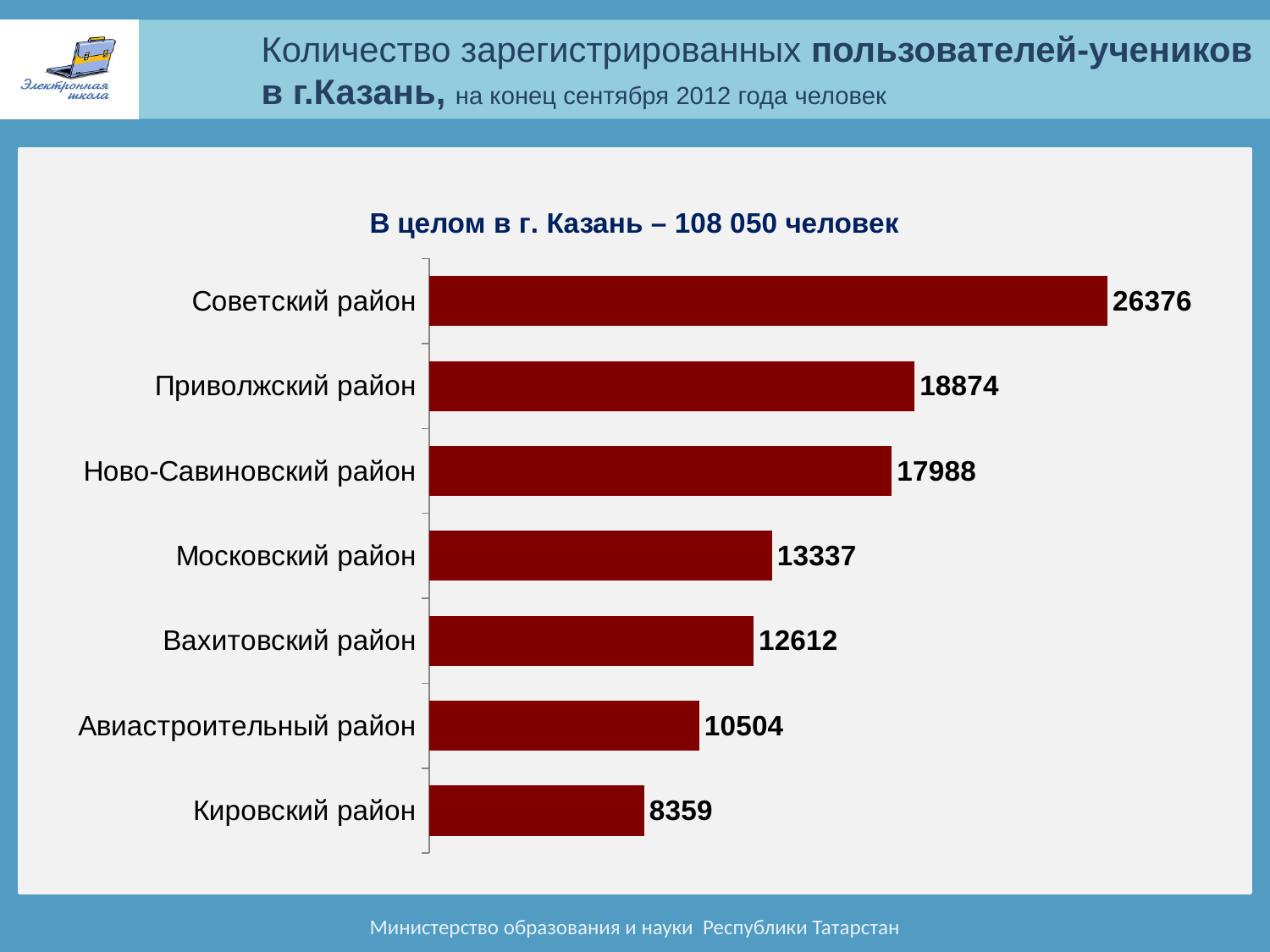
What is the value for Советский район? 26376 Which is larger, the value for Вахитовский район or the value for Московский район? Московский район What is the value for Авиастроительный район? 10504 What is the difference between the values for Советский район and Кировский район? 18017 How many districts are shown in the chart? 7 According to the chart's heading, what is the total number of registered student users in Kazan? 108 050 человек What is the value for Кировский район? 8359 What kind of chart is shown on the slide? bar chart Which district has the lowest number of registered student users? Кировский район What is the value for Московский район? 13337 Which district has the highest number of registered student users? Советский район What is the difference between the values for Приволжский район and Ново-Савиновский район? 886